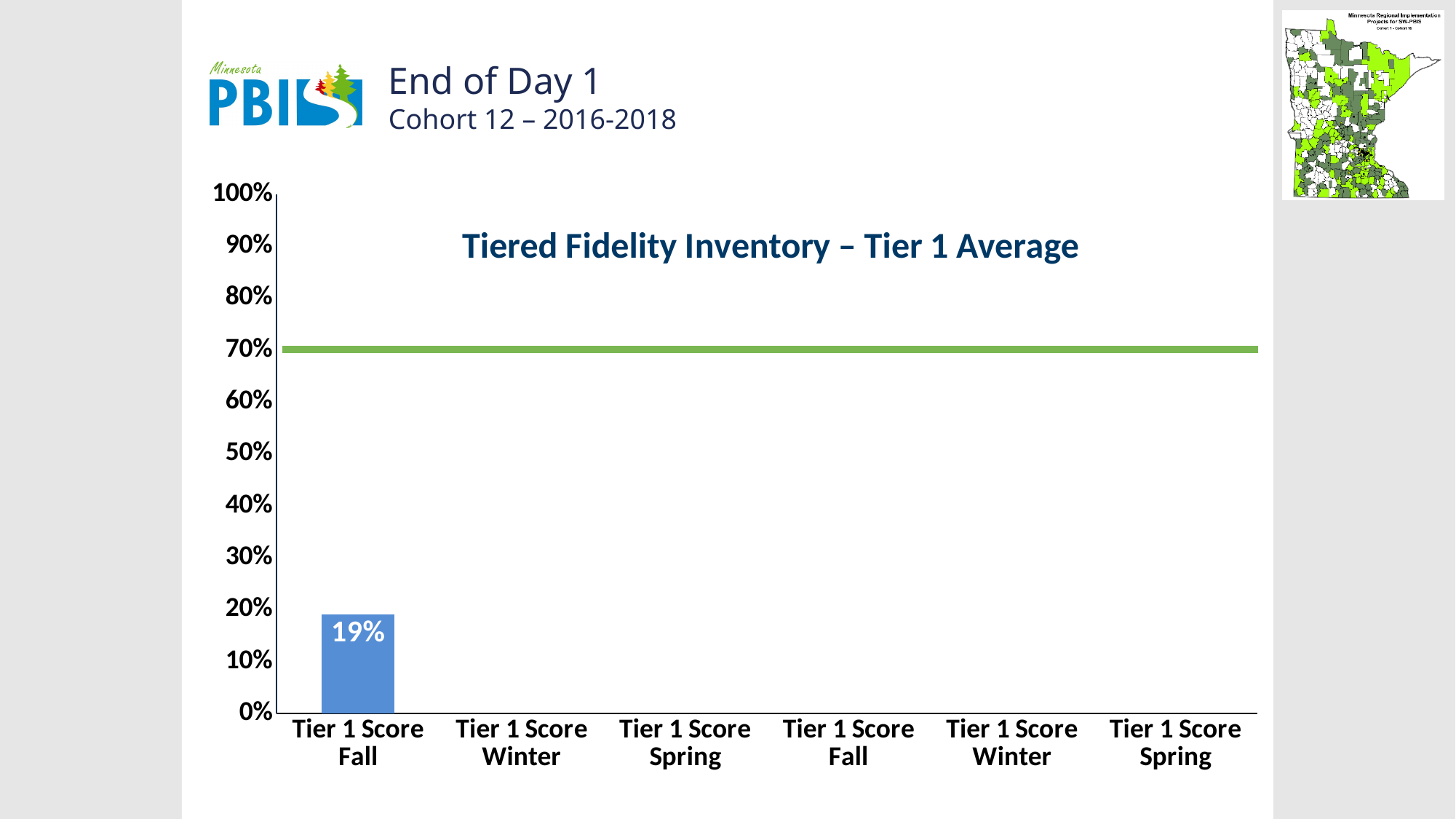
Is the first Tier 1 Score Fall bar above or below the green line? below Is the value for the first Tier 1 Score Fall greater or less than 20%? less At what value does the green horizontal line sit? 70% What is the title of the chart? Tiered Fidelity Inventory – Tier 1 Average Which category is the only one with a plotted bar? Tier 1 Score Fall (first) What is the difference between the green line value and the first Tier 1 Score Fall bar? 51% What is the highest value shown on the y axis? 100% What is the value of the first Tier 1 Score Fall bar? 19% What kind of chart is shown on the slide? bar chart How many categories are shown on the x axis? 6